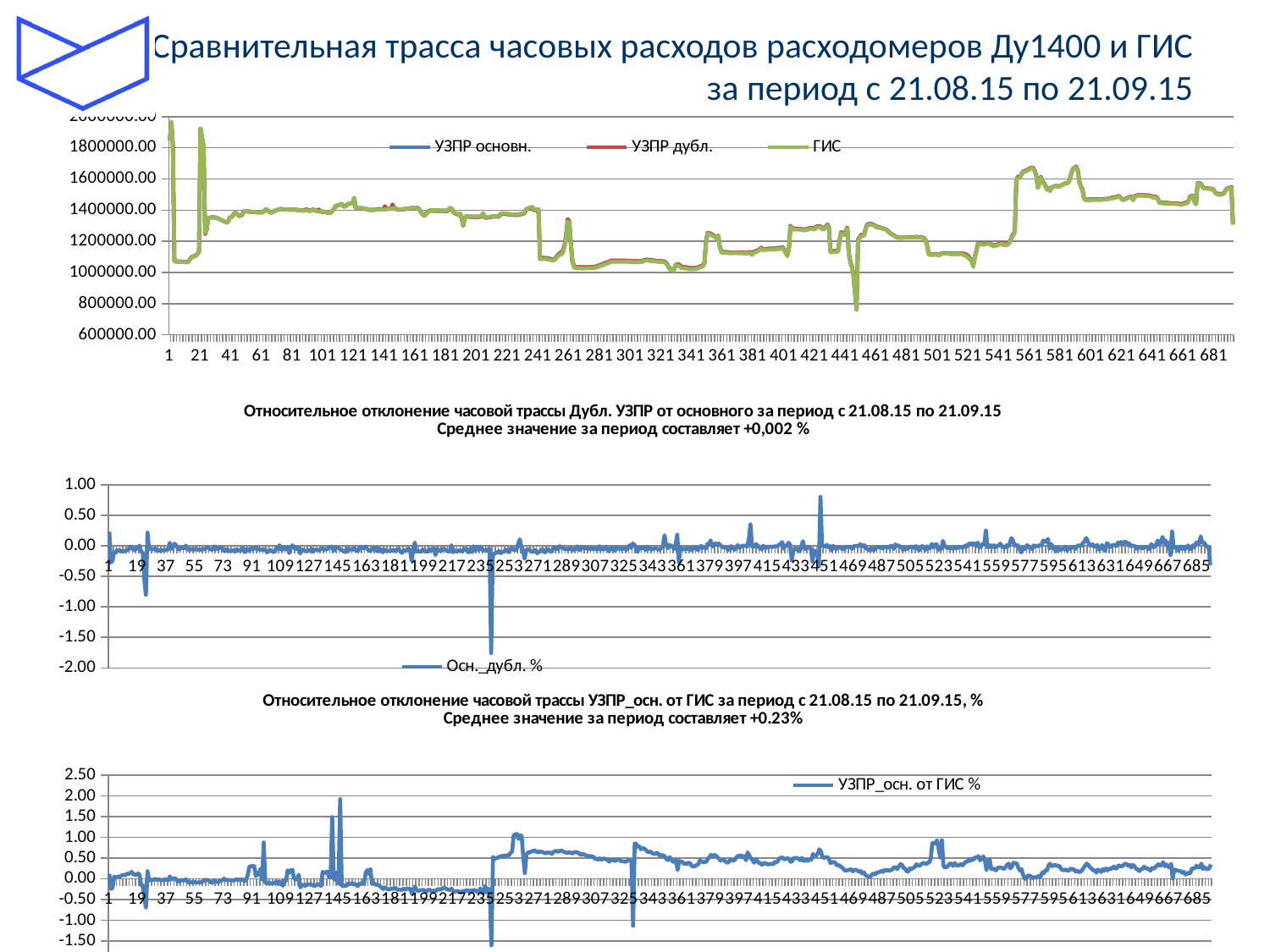
In the middle chart, is the deepest negative spike (around x = 235–253) greater or less than -1.50? less According to the title of the middle chart, what is the average relative deviation of the duplicate УЗПР from the main one over the period? +0,002 % In the top chart, is the value at x = 1 greater or less than 1800000.00? greater How many series does the legend of the top chart list? 3 What kind of chart is the top chart on the slide? line chart According to the title of the bottom chart, what is the average relative deviation of УЗПР_осн. from ГИС over the period? +0.23% What is the name of the series shown in the legend of the bottom chart? УЗПР_осн. от ГИС % How many series does the legend of the middle chart list? 1 In the bottom chart, is the highest spike (around x = 145) greater or less than 1.50? greater What are the three series named in the legend of the top chart? УЗПР основн., УЗПР дубл., ГИС